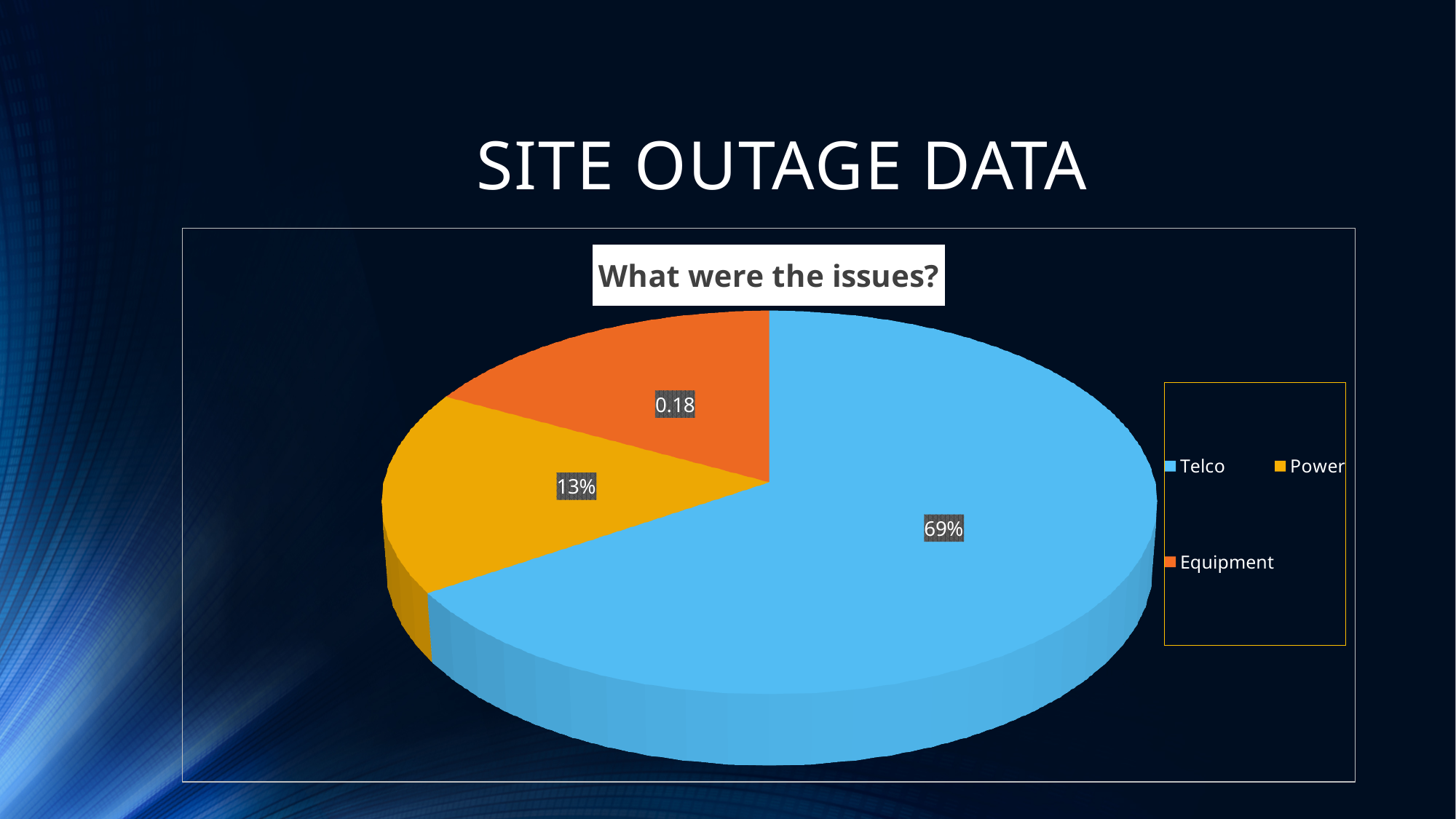
Which colour represents Equipment in the chart? orange Which is larger, the Telco slice or the Power slice? Telco How many entries does the legend list? 3 What percentage of the pie does Telco account for? 69% What type of chart is shown on the slide? pie chart Which issue category has the largest slice of the pie? Telco What value is shown for the Power slice? 13% What is the chart's title? What were the issues? What value is printed on the Equipment slice? 0.18 How many categories are shown in the pie chart? 3